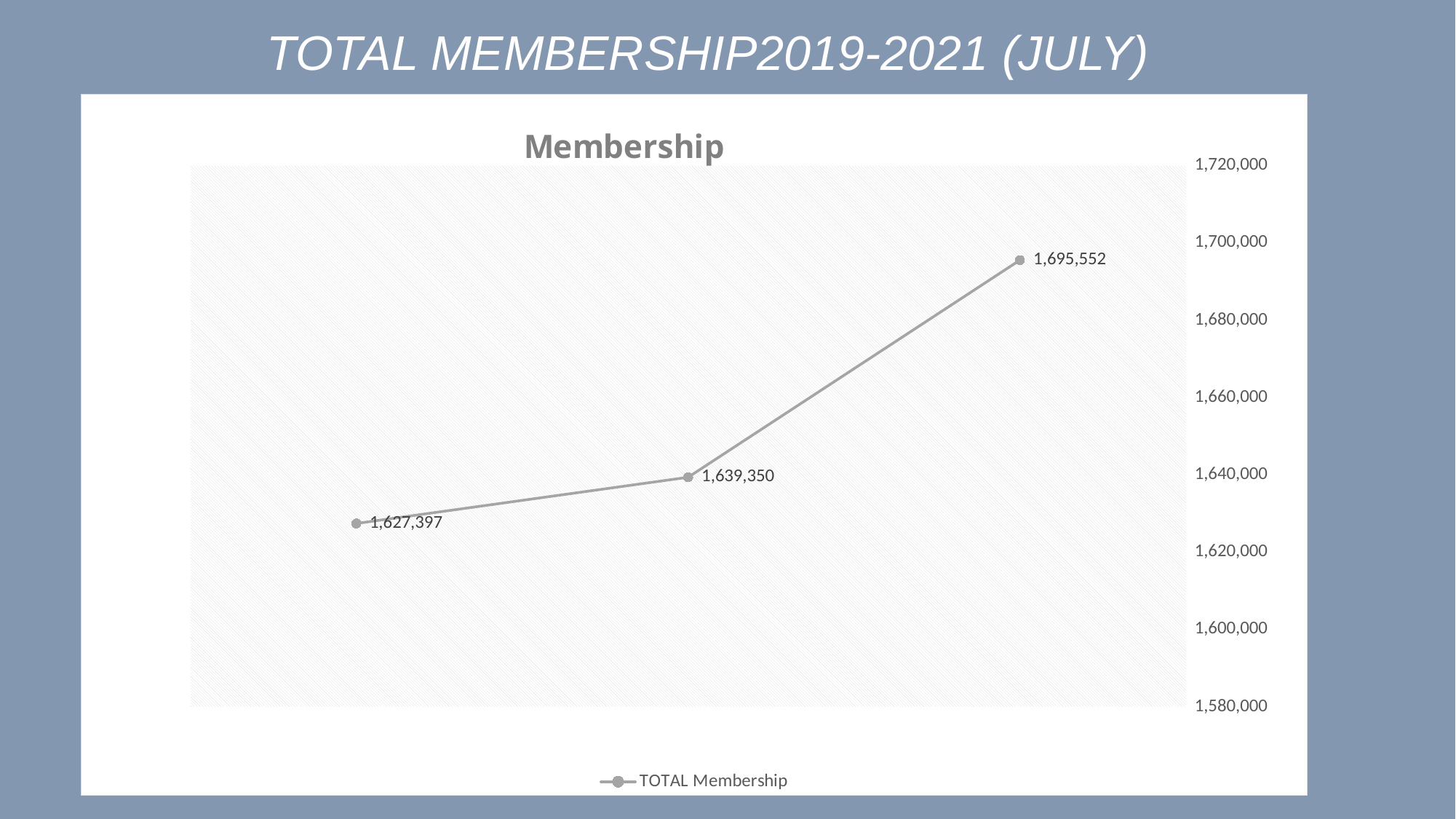
What type of chart is shown on the slide? line chart What is the highest value plotted on the chart? 1,695,552 What is the title of the chart? Membership What is the lowest value plotted on the chart? 1,627,397 What is the value of the last (rightmost) data point? 1,695,552 What is the value of the middle data point? 1,639,350 What is the difference between the last data point and the first data point? 68,155 What is the value of the first (leftmost) data point? 1,627,397 How many data points are plotted on the line? 3 How many series does the legend list? 1 Do the values rise or fall from left to right along the line? rise What series does the legend list? TOTAL Membership